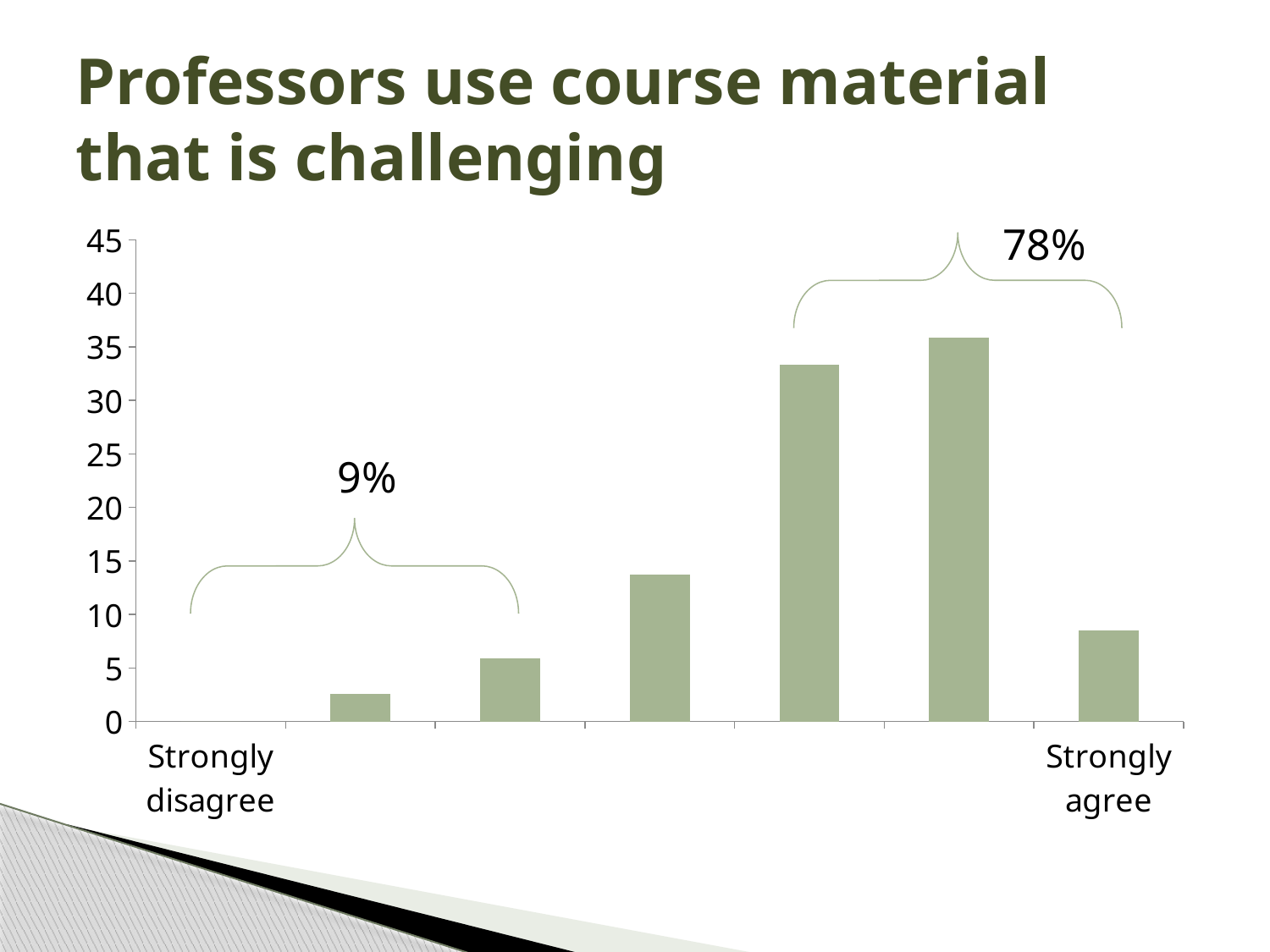
Is the value for the tallest bar greater or less than 30? greater What is the title of the chart on the slide? Professors use course material that is challenging How many bars are visible in the chart? 6 Is the value for the shortest visible bar greater or less than 5? less Is the value for the middle bar (fourth from the left) greater or less than 10? greater Which is larger, the Strongly agree bar or the bar immediately to its left? the bar immediately to its left What percentage is shown above the bracket on the left side of the chart? 9% What percentage is shown above the bracket on the right side of the chart? 78% What kind of chart is shown on the slide? bar chart